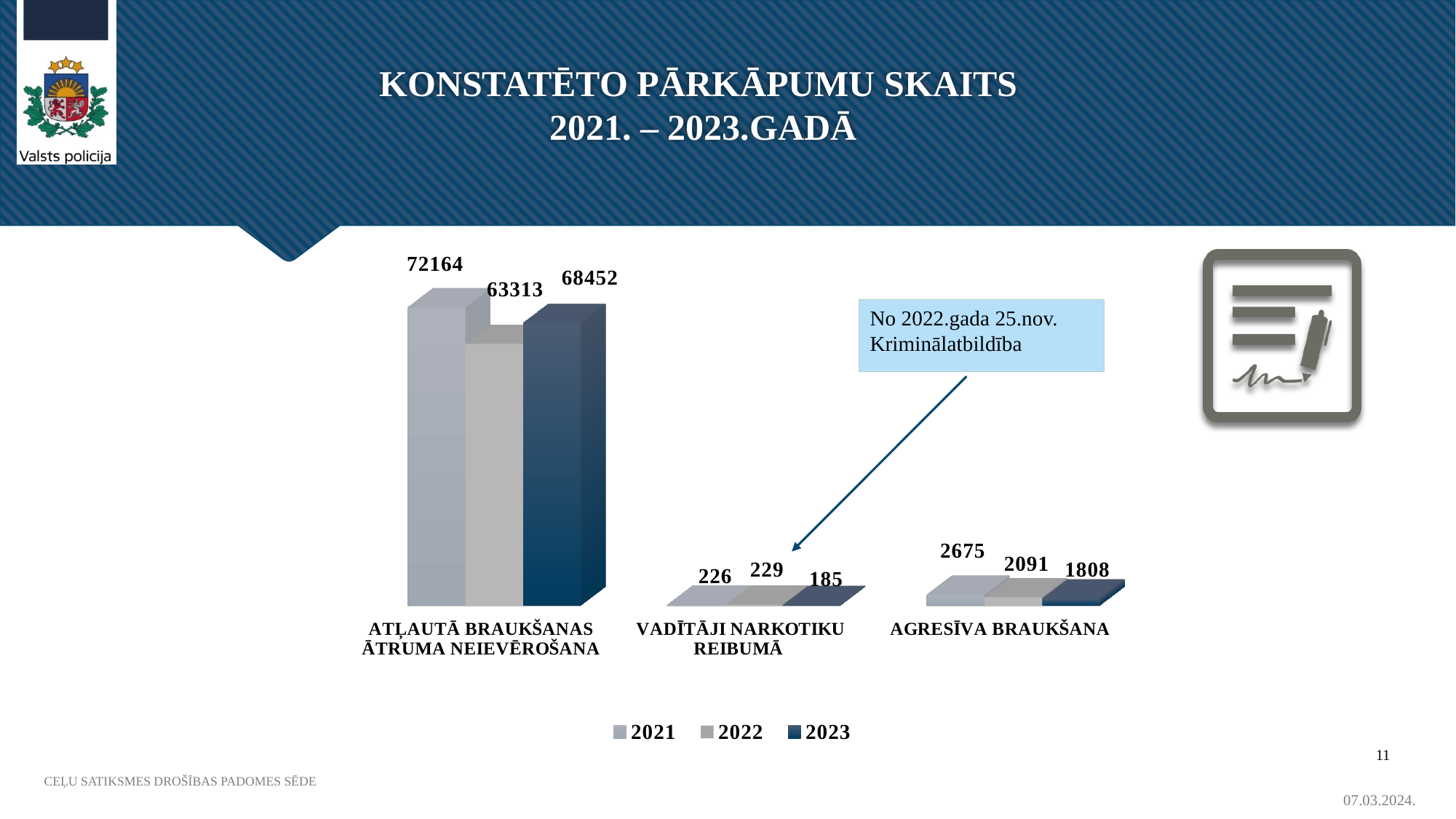
Which year has the lowest value in the VADĪTĀJI NARKOTIKU REIBUMĀ category? 2023 What is the value for 2021 in the ATĻAUTĀ BRAUKŠANAS ĀTRUMA NEIEVĒROŠANA category? 72164 What kind of chart is shown on the slide? Bar chart Which is larger in the AGRESĪVA BRAUKŠANA category: the 2022 value or the 2023 value? 2022 What is the difference between the 2021 and 2023 values in the AGRESĪVA BRAUKŠANA category? 867 Do the values for AGRESĪVA BRAUKŠANA rise or fall from 2021 to 2023? Fall Which year has the highest value in the ATĻAUTĀ BRAUKŠANAS ĀTRUMA NEIEVĒROŠANA category? 2021 What is the value for 2022 in the VADĪTĀJI NARKOTIKU REIBUMĀ category? 229 What is the difference between the 2021 and 2022 values in the ATĻAUTĀ BRAUKŠANAS ĀTRUMA NEIEVĒROŠANA category? 8851 How many series does the legend list? 3 What is the value for 2023 in the AGRESĪVA BRAUKŠANA category? 1808 How many categories are shown on the x axis of the chart? 3